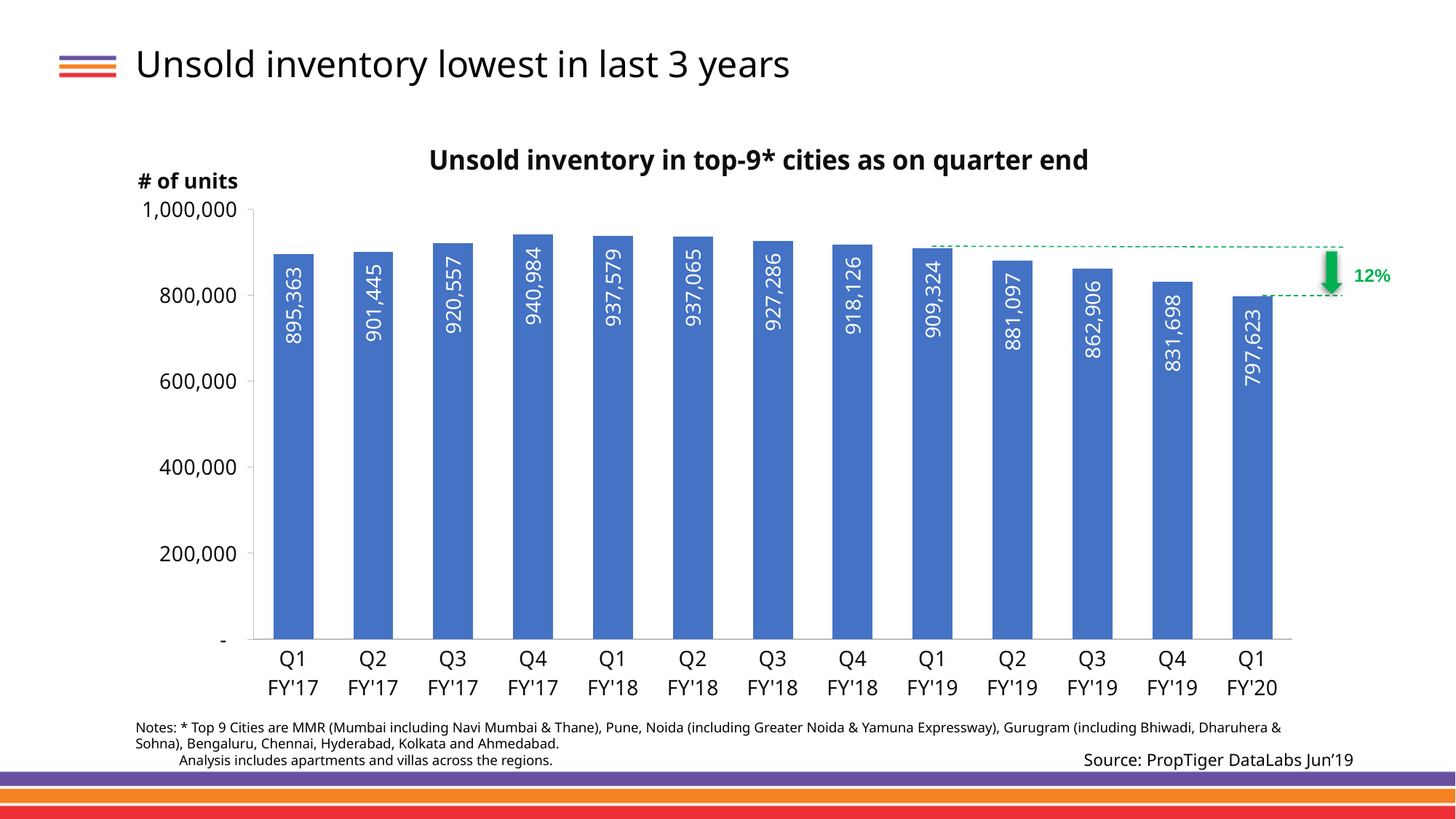
Do the unsold inventory values rise or fall from Q4 FY'17 to Q1 FY'20? Fall What is the unsold inventory value for Q4 FY'17? 940,984 What is the difference in unsold inventory between Q1 FY'19 and Q1 FY'20? 111,701 What is the unsold inventory value for Q2 FY'19? 881,097 How many quarters are shown on the chart? 13 Which quarter has the lowest unsold inventory? Q1 FY'20 What is the title of the chart? Unsold inventory in top-9* cities as on quarter end Which quarter has the highest unsold inventory? Q4 FY'17 What kind of chart is shown on the slide? Bar chart Is the value for Q1 FY'20 greater or less than 800,000? less What is the unsold inventory value for Q1 FY'20? 797,623 Which is larger, the unsold inventory in Q2 FY'19 or in Q3 FY'19? Q2 FY'19